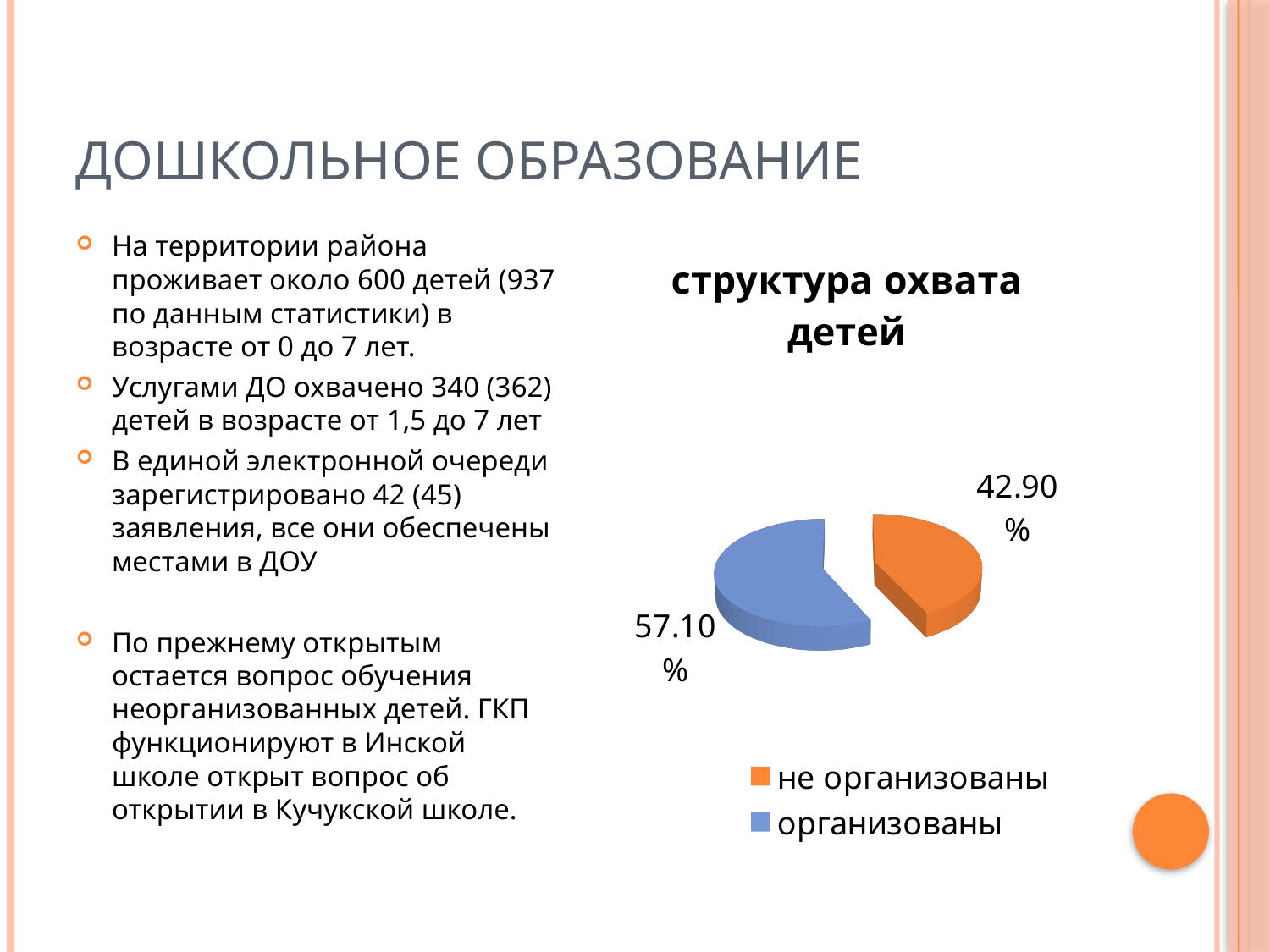
Which category has the largest share of the pie? организованы What is the value for "не организованы"? 42.90% How many entries does the legend list? 2 Which is larger: the share for "организованы" or for "не организованы"? организованы What type of chart is shown on the slide? pie chart How many slices does the pie chart have? 2 Which category has the smallest share of the pie? не организованы What colour is the slice for "не организованы"? orange What is the difference between the shares for "организованы" and "не организованы"? 14.20% What is the value for "организованы"? 57.10% What is the title of the chart? структура охвата детей